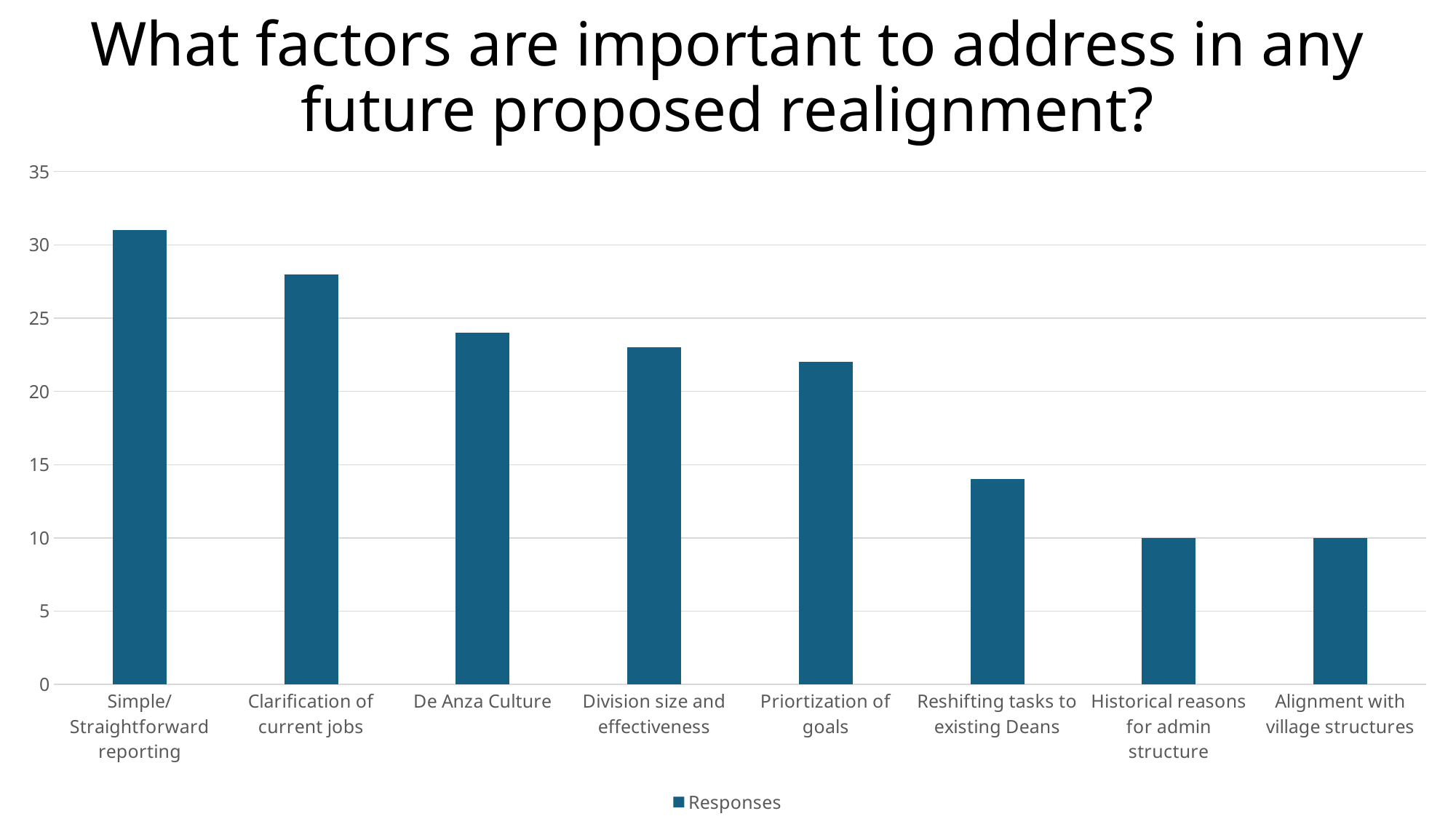
Is the value for Clarification of current jobs greater or less than 25? greater How many series does the chart's legend list? 1 What is the value for Historical reasons for admin structure? 10 Do the values generally rise or fall moving from left to right along the x axis? fall How many categories are shown on the x axis of the chart? 8 What kind of chart is shown on the slide? bar chart Is the value for Reshifting tasks to existing Deans greater or less than 15? less Which is larger, the value for Priortization of goals or the value for Reshifting tasks to existing Deans? Priortization of goals What series name is shown in the chart's legend? Responses Which category has the highest number of responses? Simple/ Straightforward reporting Is the value for De Anza Culture greater or less than 25? less